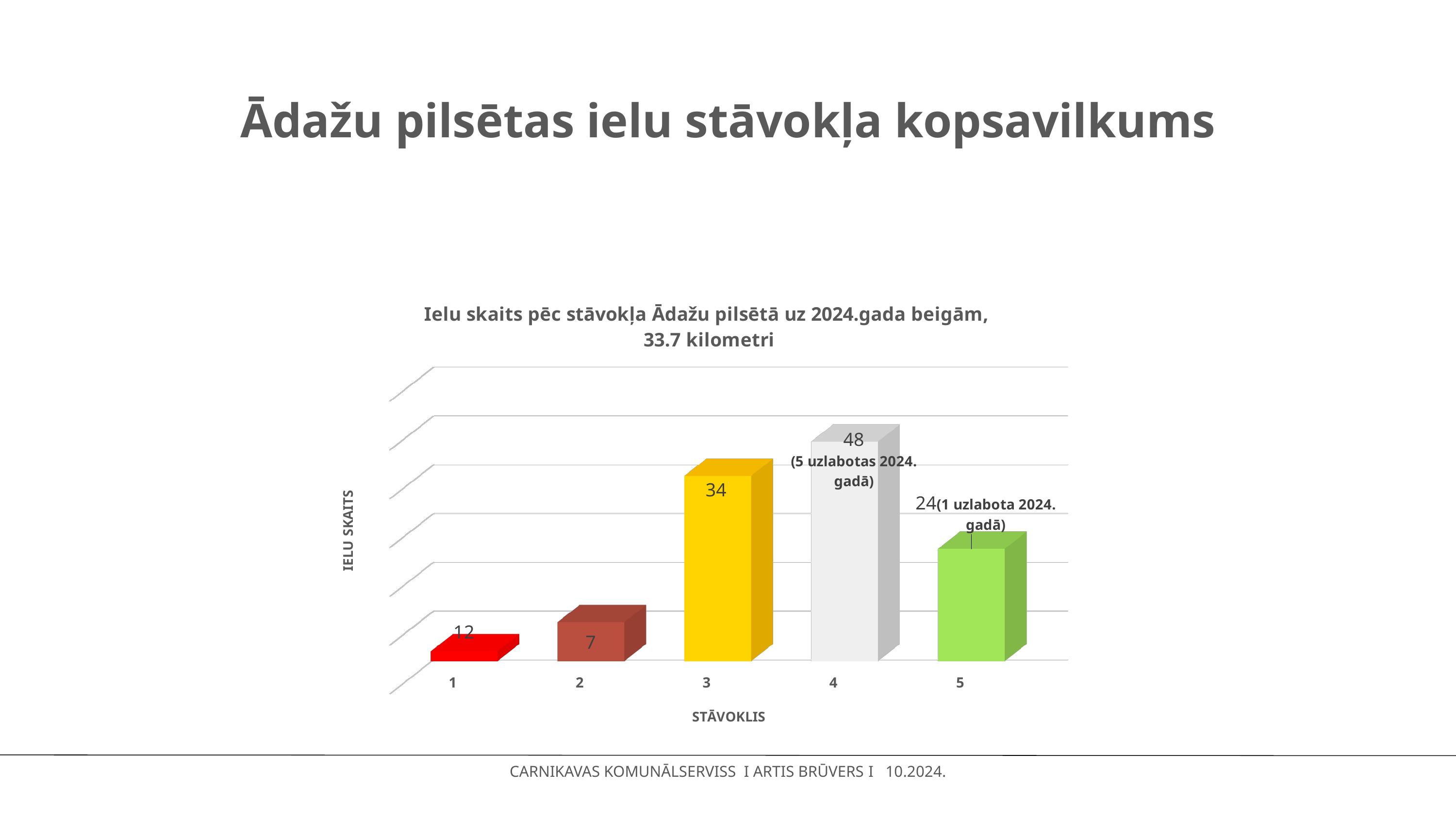
Which is larger, the value for condition 5 or the value for condition 1? condition 5 What is the value for condition (stāvoklis) 1? 12 What is the difference between the values for condition 4 and condition 3? 14 What is the value for condition (stāvoklis) 3? 34 How many condition categories are shown on the x axis? 5 What is the value for condition (stāvoklis) 4? 48 Which condition category has the highest number of streets? 4 What kind of chart is shown on the slide? bar chart What is the label of the x axis of the chart? STĀVOKLIS What is the value for condition (stāvoklis) 5? 24 What is the value for condition (stāvoklis) 2? 7